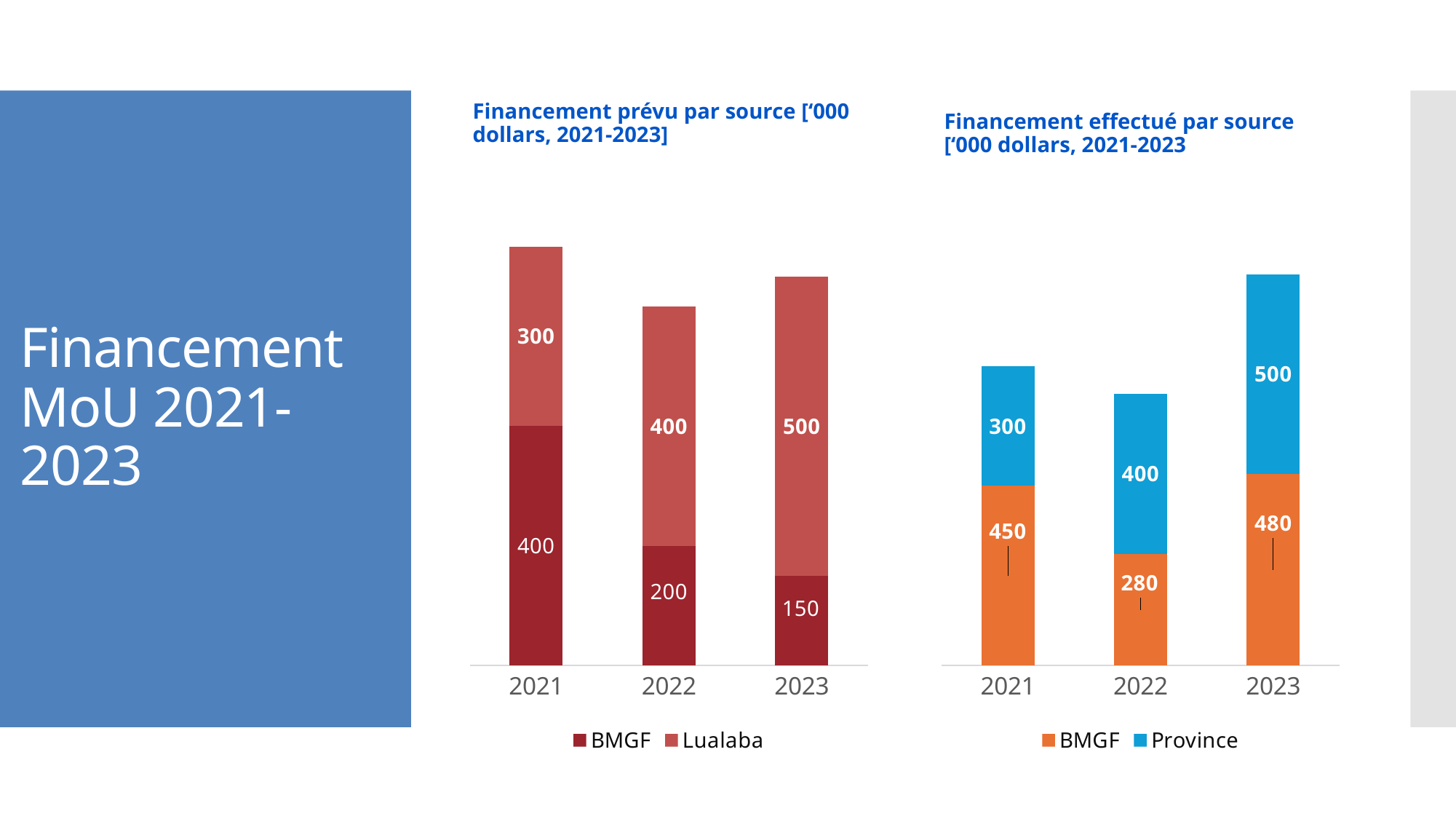
In the 'Financement effectué par source' chart, what is the BMGF value for 2022? 280 How many series does the legend of the 'Financement effectué par source' chart list? 2 In the 'Financement prévu par source' chart, what is the Lualaba value for 2023? 500 In the 'Financement prévu par source' chart, is the Lualaba value for 2022 larger or smaller than the BMGF value for 2022? larger In the 'Financement effectué par source' chart, what is the difference between the BMGF values for 2021 and 2022? 170 In the 'Financement prévu par source' chart, how do the Lualaba values change from 2021 to 2023? They rise In the 'Financement prévu par source' chart, what is the BMGF value for 2021? 400 In the 'Financement effectué par source' chart, which year has the highest Province value? 2023 In the 'Financement effectué par source' chart, what is the total of the stacked bar for 2023? 980 In the 'Financement prévu par source' chart, which year has the lowest BMGF value? 2023 In the 'Financement prévu par source' chart, what is the total of the stacked bar for 2021? 700 In the 'Financement effectué par source' chart, what is the Province value for 2023? 500